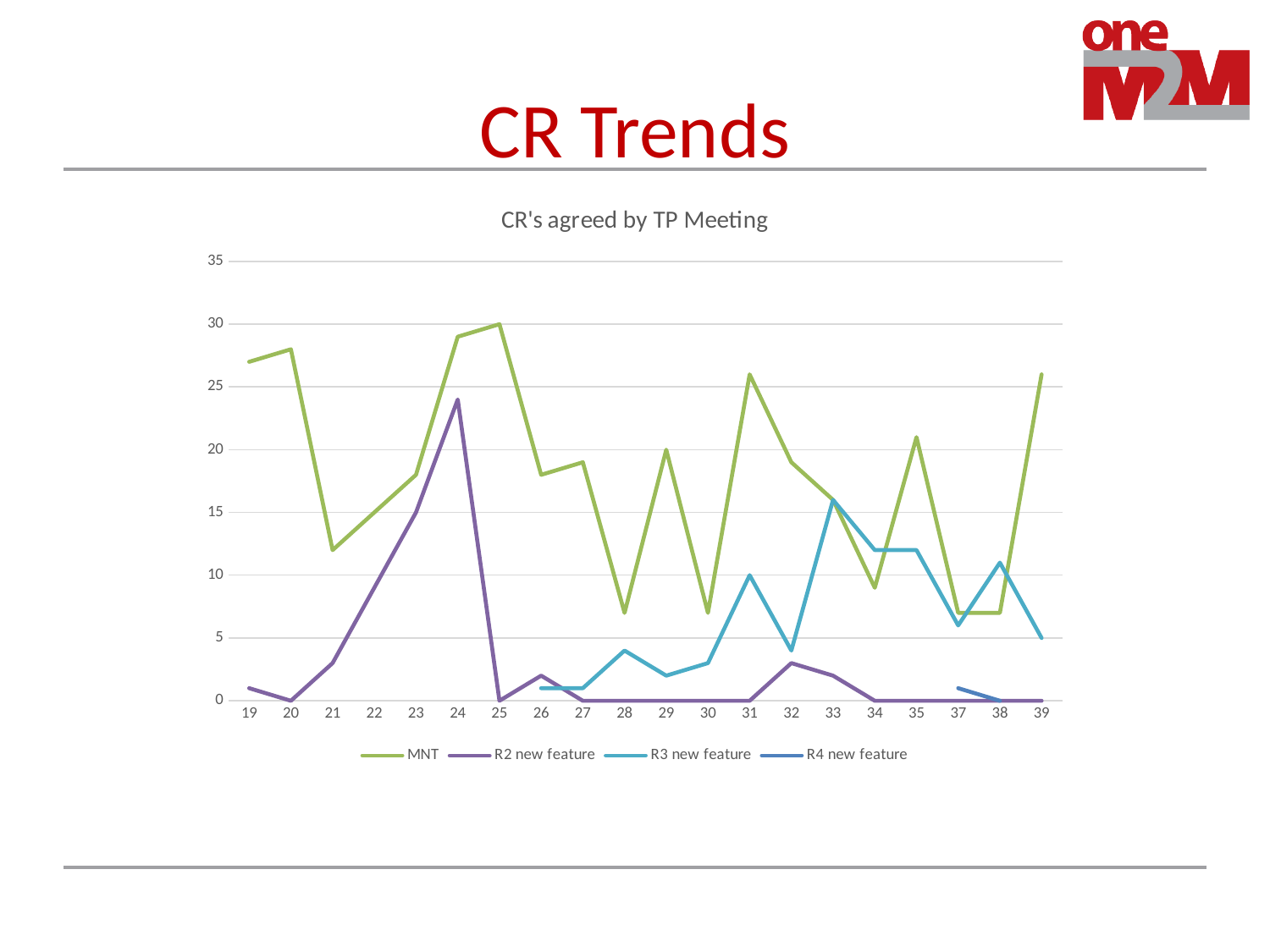
What is the R2 new feature value at TP meeting 28? 0 At which TP meeting does the R3 new feature series reach its highest value? 33 What is the MNT value at TP meeting 25? 30 What is the R3 new feature value at TP meeting 31? 10 At TP meeting 35, which series has the larger value, MNT or R3 new feature? MNT How many series does the legend list? 4 At which TP meeting does the R2 new feature series reach its highest value? 24 How many TP meeting numbers are shown on the x axis? 20 What is the title of the chart? CR's agreed by TP Meeting Is the R3 new feature value at TP meeting 32 greater or less than 5? less What kind of chart is shown on the slide? line chart Is the MNT value at TP meeting 19 greater or less than 25? greater